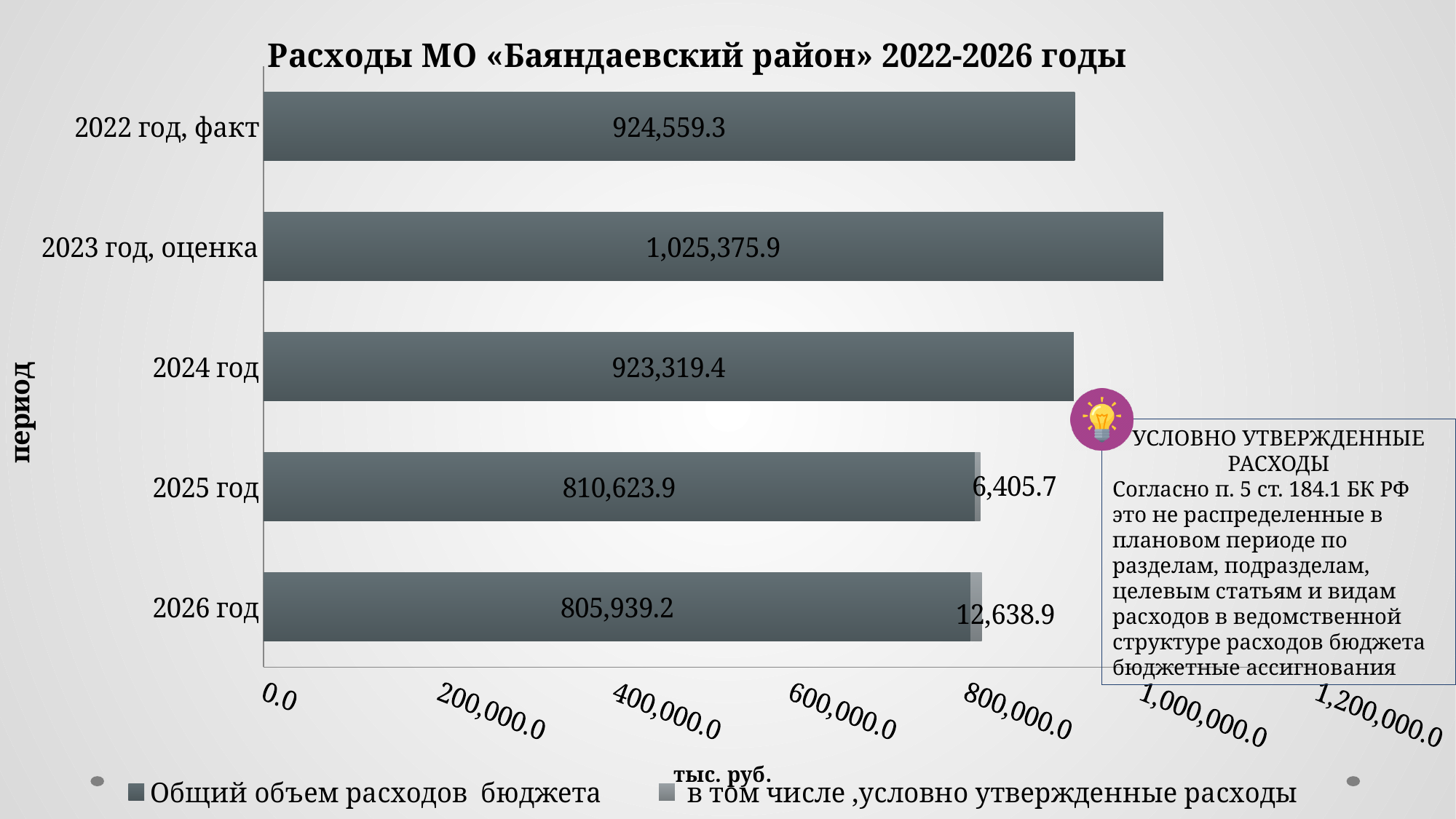
What is the total budget expenditure (Общий объем расходов бюджета) for 2023 год, оценка? 1,025,375.9 What is the value of conditionally approved expenditures (условно утвержденные расходы) for 2026 год? 12,638.9 By how much do the conditionally approved expenditures for 2026 год exceed those for 2025 год? 6,233.2 Which period has the highest total budget expenditure? 2023 год, оценка Which has the larger total budget expenditure, 2025 год or 2026 год? 2025 год What is the total budget expenditure (Общий объем расходов бюджета) for 2026 год? 805,939.2 How many periods are shown on the chart? 5 What is the value of conditionally approved expenditures (условно утвержденные расходы) for 2025 год? 6,405.7 What is the difference between the total budget expenditure for 2022 год, факт and 2024 год? 1,239.9 What type of chart is shown on the slide? Bar chart Which period has the lowest total budget expenditure? 2026 год How many series does the legend list? 2